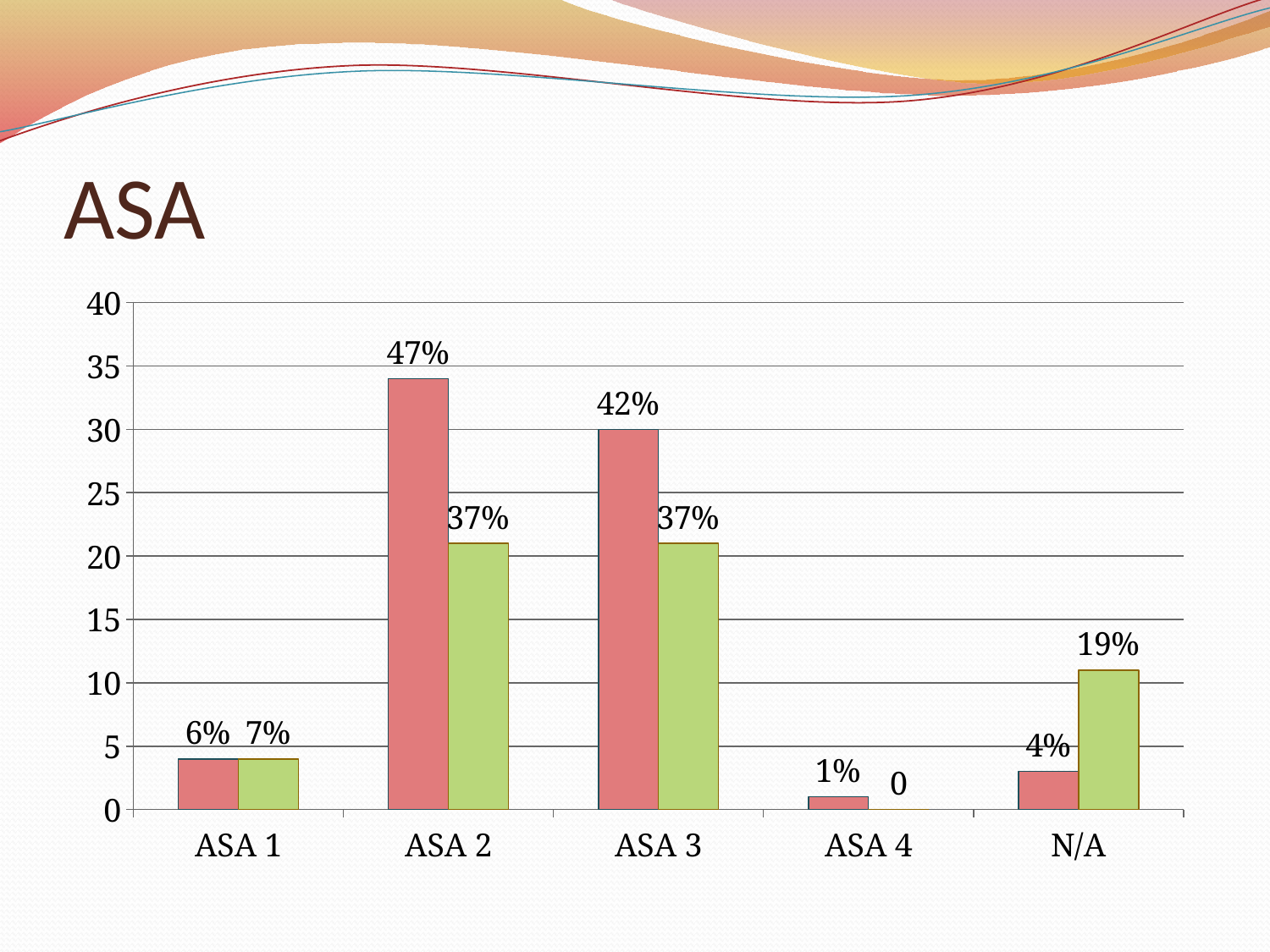
What kind of chart is shown on the slide? bar chart Is the red bar for ASA 3 greater or less than 25 on the y axis? greater What data label is shown on the red bar for ASA 4? 1% What data label is shown on the green bar for N/A? 19% How many categories are shown on the x axis of the chart? 5 What is the title of the slide containing the chart? ASA What data label is shown on the red bar for ASA 2? 47% Which category has the tallest red bar? ASA 2 Which category has the lowest green bar? ASA 4 What data label is shown on the green bar for ASA 4? 0 For N/A, which bar is taller, the red bar or the green bar? green bar Is the green bar for ASA 1 greater or less than 10 on the y axis? less